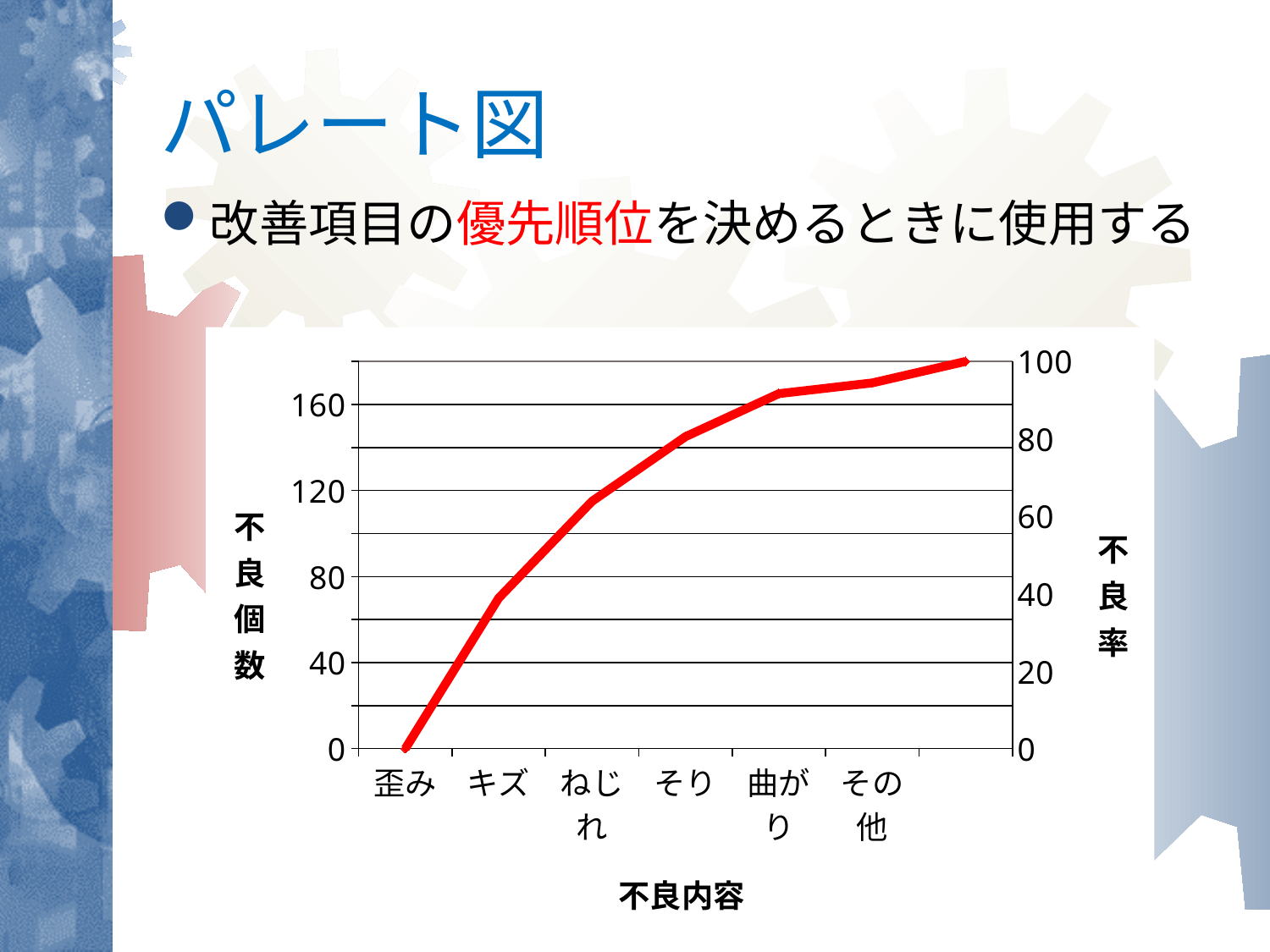
Which labelled category has the lowest value on the red line? 歪み Is the value of the red line at キズ greater or less than 40 on the left axis? greater How many categories are labelled on the x axis of the chart? 6 Does the red line rise or fall from left to right across the categories? rises Is the value of the red line at そり greater or less than 120 on the left axis? greater What is the title of the left vertical axis? 不良個数 Is the value of the red line at その他 greater or less than 80 on the right axis? greater What is the value of the red line at 歪み on the left axis? 0 What kind of chart is shown on the slide? line chart What is the title of the horizontal axis? 不良内容